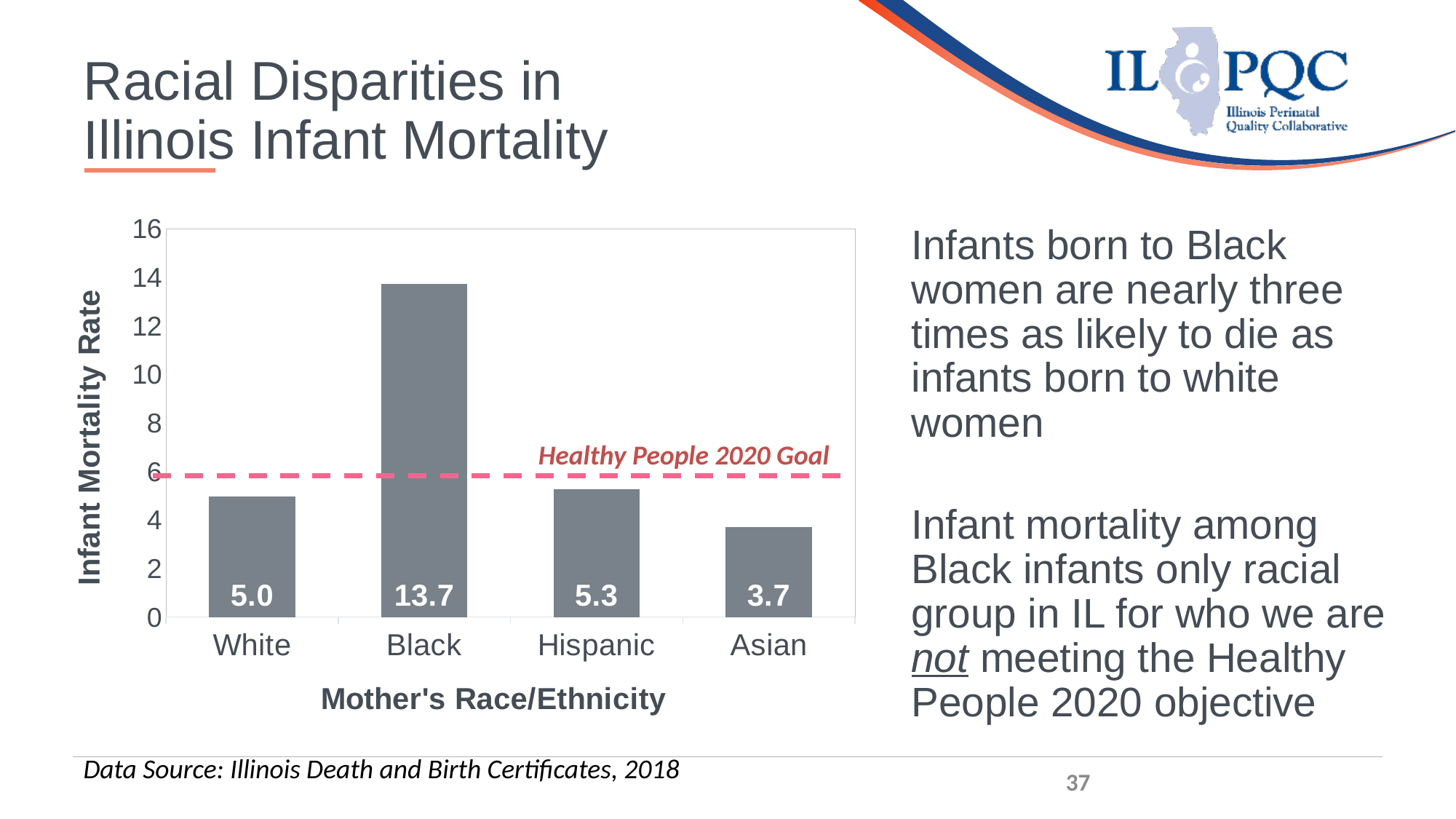
Is the infant mortality rate for Black mothers greater or less than 12? greater Which race/ethnicity group has the lowest infant mortality rate? Asian Which race/ethnicity group has the highest infant mortality rate? Black Which group has a higher infant mortality rate, Hispanic or Asian? Hispanic What is the infant mortality rate for infants born to White mothers? 5.0 What is the infant mortality rate for infants born to Black mothers? 13.7 What does the dashed horizontal line on the chart represent? Healthy People 2020 Goal How many race/ethnicity categories are shown on the x axis? 4 What is the difference between the infant mortality rate for Black mothers and for White mothers? 8.7 What kind of chart is shown on the slide? Bar chart What is the infant mortality rate for infants born to Asian mothers? 3.7 What is the infant mortality rate for infants born to Hispanic mothers? 5.3